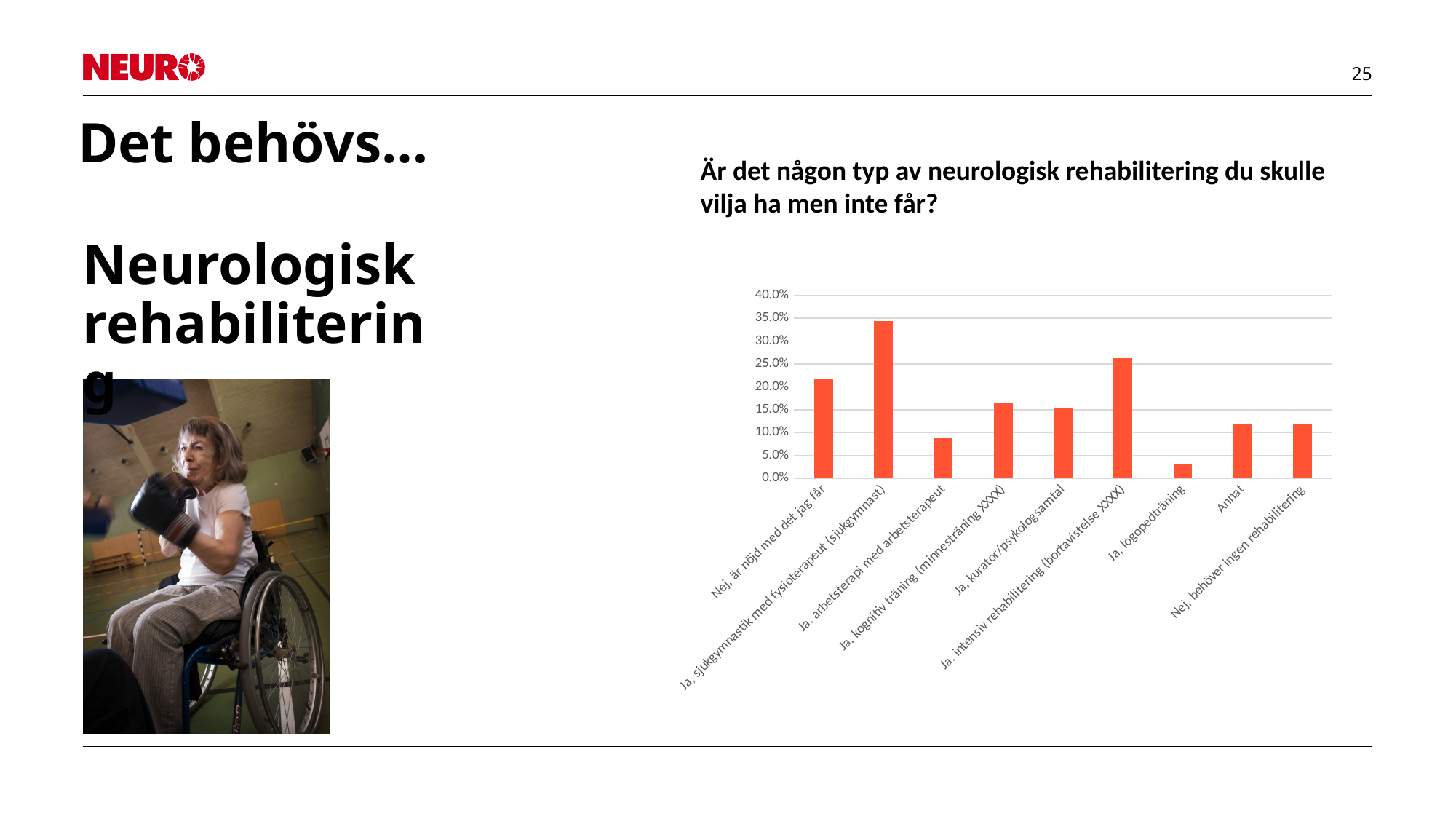
Which is larger: the value for 'Ja, intensiv rehabilitering (bortavistelse XXXX)' or the value for 'Nej, är nöjd med det jag får'? Ja, intensiv rehabilitering (bortavistelse XXXX) Is the value for 'Ja, intensiv rehabilitering (bortavistelse XXXX)' greater or less than 25.0%? greater Is the value for 'Ja, logopedträning' greater or less than 5.0%? less How many categories are shown on the x axis of the chart? 9 Is the value for 'Ja, arbetsterapi med arbetsterapeut' greater or less than 10.0%? less Which category has the highest bar in the chart? Ja, sjukgymnastik med fysioterapeut (sjukgymnast) Which is larger: the value for 'Ja, kognitiv träning (minnesträning XXXX)' or the value for 'Annat'? Ja, kognitiv träning (minnesträning XXXX) Which category has the lowest bar in the chart? Ja, logopedträning What kind of chart is shown on the slide? Bar chart What is the title of the chart on the slide? Är det någon typ av neurologisk rehabilitering du skulle vilja ha men inte får?